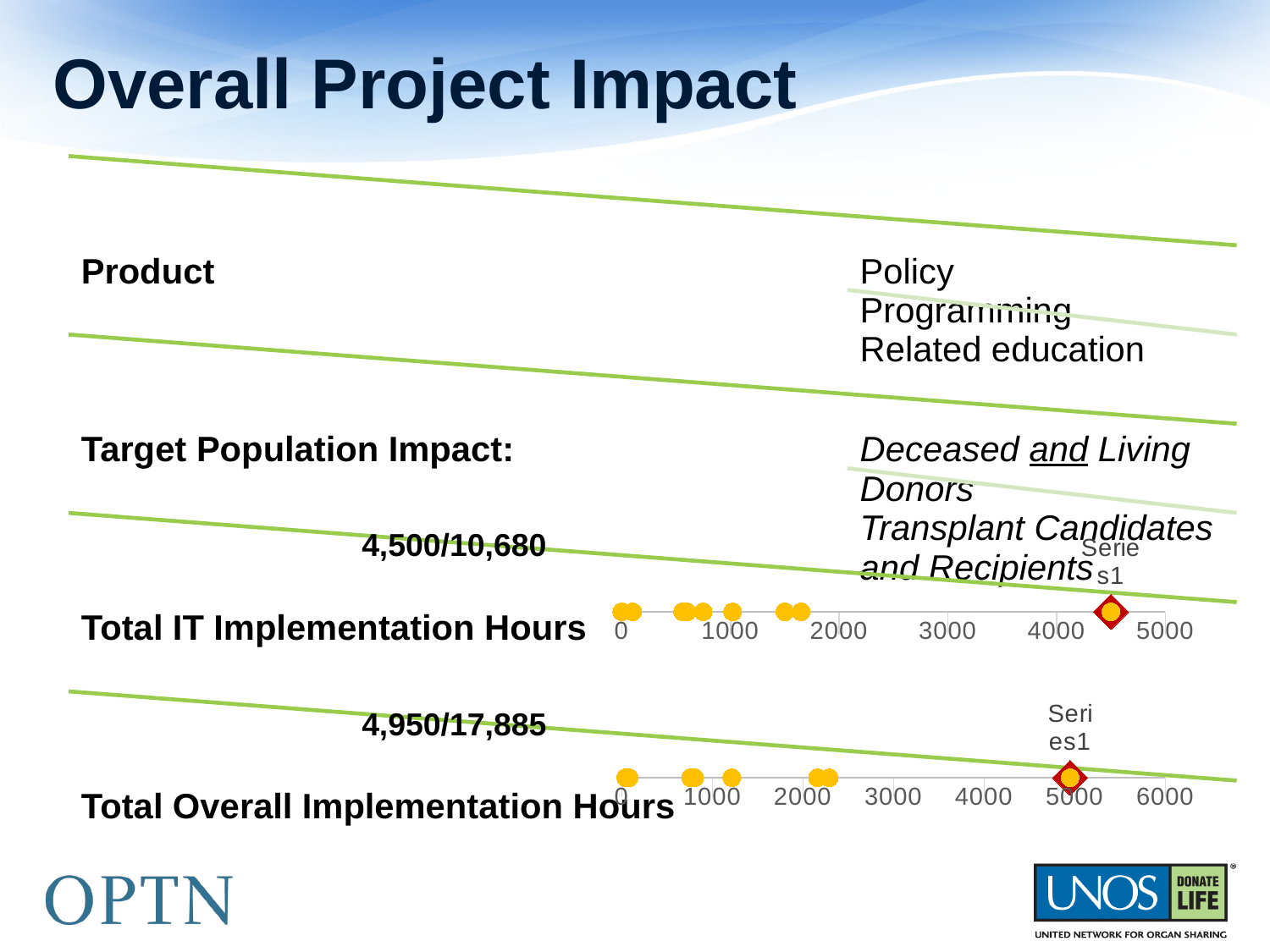
In the chart next to "Total Overall Implementation Hours", is the value of the red diamond marker greater or less than 4000? greater In the chart next to "Total IT Implementation Hours", is the value of the red diamond marker greater or less than 4000? greater In the chart next to "Total IT Implementation Hours", is the leftmost yellow point greater or less than 1000? less What kind of chart is the chart next to "Total IT Implementation Hours"? scatter chart In the chart next to "Total IT Implementation Hours", which marker has the highest value: the red diamond or any of the yellow points? the red diamond What is the highest axis tick shown on the chart next to "Total IT Implementation Hours"? 5000